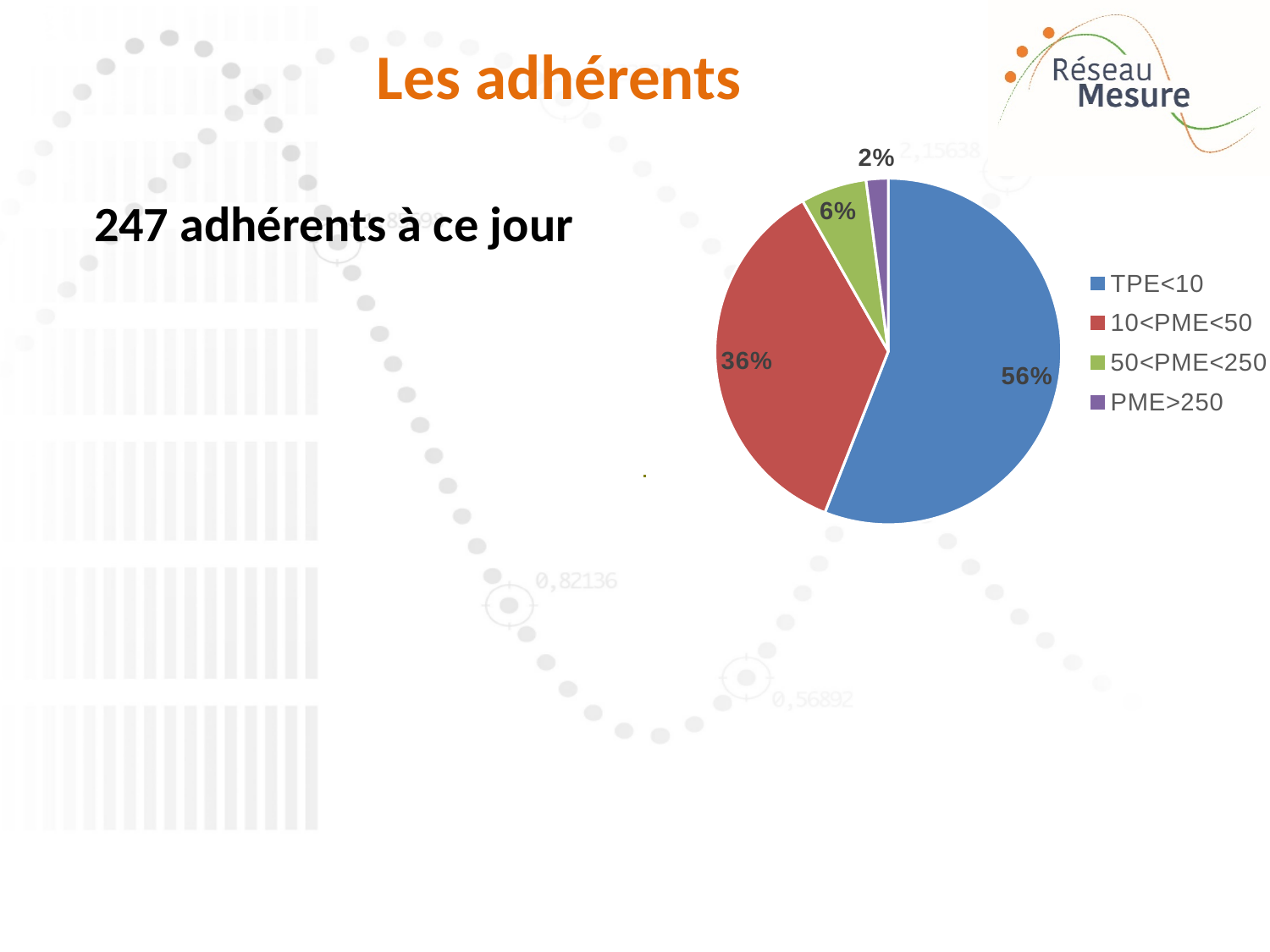
Which category has the smallest slice of the pie? PME>250 Which legend entry is shown in blue? TPE<10 What share of the pie does 10<PME<50 represent? 36% What is the difference in percentage points between TPE<10 and 10<PME<50? 20 How many categories does the pie chart show? 4 Which category has the largest slice of the pie? TPE<10 What colour is the slice for 10<PME<50? red Which is larger, the share for 50<PME<250 or the share for PME>250? 50<PME<250 What share of the pie does PME>250 represent? 2% What share of the pie does 50<PME<250 represent? 6% What kind of chart is shown on the slide? pie chart